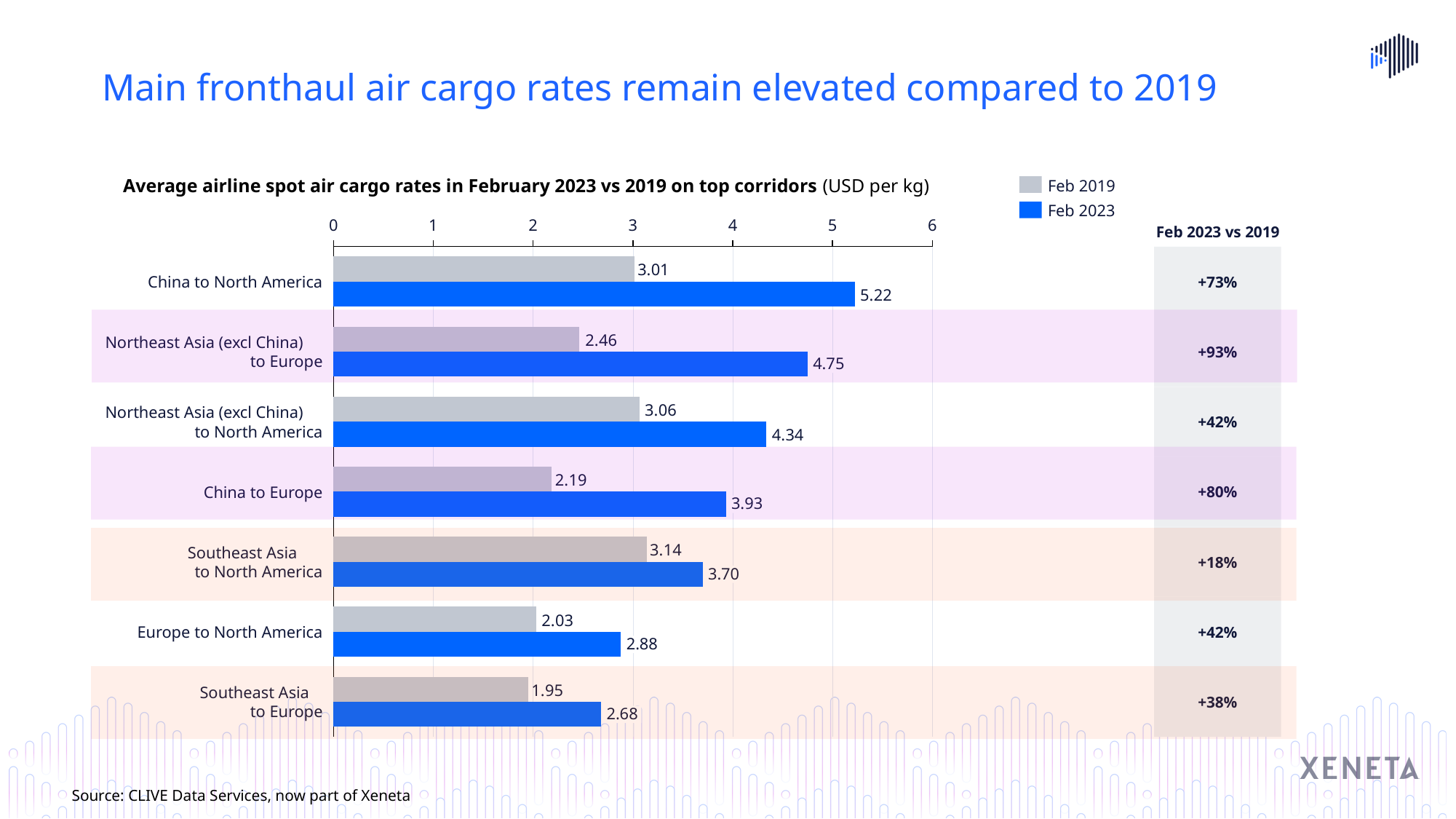
What is the difference between the Feb 2023 and Feb 2019 rates for China to Europe? 1.74 Which corridor has the highest Feb 2023 rate? China to North America Which is larger: the Feb 2019 rate for Northeast Asia (excl China) to North America or the Feb 2019 rate for Southeast Asia to North America? Southeast Asia to North America Is the Feb 2023 rate for Europe to North America greater or less than 3? less What was the Feb 2019 average spot air cargo rate for Southeast Asia to Europe? 1.95 How many series does the legend list? 2 Which corridor has the lowest Feb 2019 rate? Southeast Asia to Europe Which colour represents Feb 2023 in the chart? blue What was the Feb 2023 average spot air cargo rate for China to North America? 5.22 What is the percentage change shown for Northeast Asia (excl China) to Europe between Feb 2019 and Feb 2023? +93% What kind of chart is shown on the slide? bar chart How many corridors are shown in the chart? 7